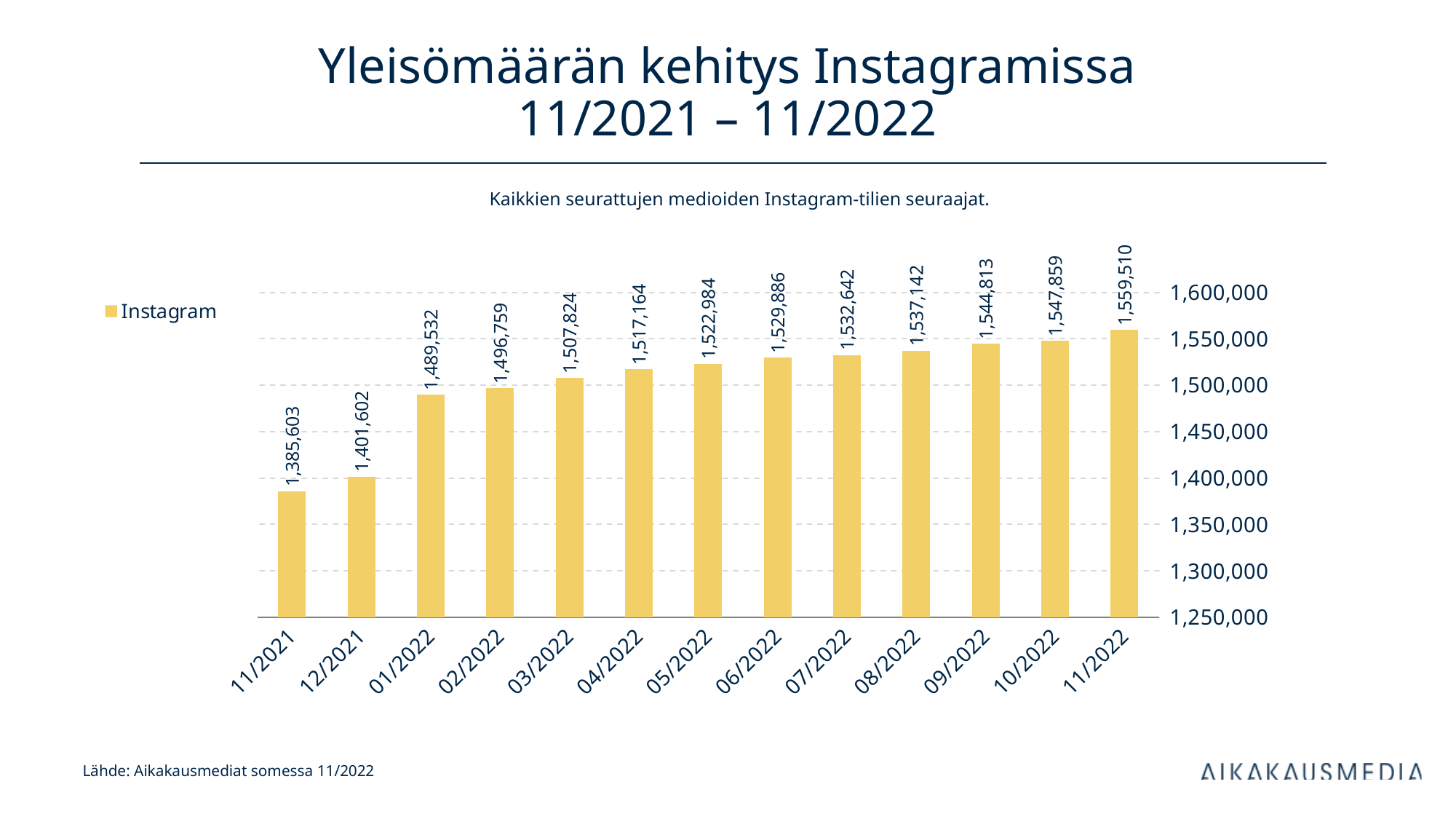
Which month has the highest value? 11/2022 What is the difference between the values for 11/2022 and 11/2021? 173,907 What is the value for 11/2022? 1,559,510 Which is larger, the value for 03/2022 or the value for 02/2022? 03/2022 Is the value for 12/2021 greater or less than 1,450,000? less What is the value for 11/2021? 1,385,603 What kind of chart is shown on the slide? bar chart Do the values rise or fall from 11/2021 to 11/2022? rise How many months are shown on the x axis? 13 What is the value for 05/2022? 1,522,984 What is the difference between the values for 01/2022 and 12/2021? 87,930 Which month has the lowest value? 11/2021